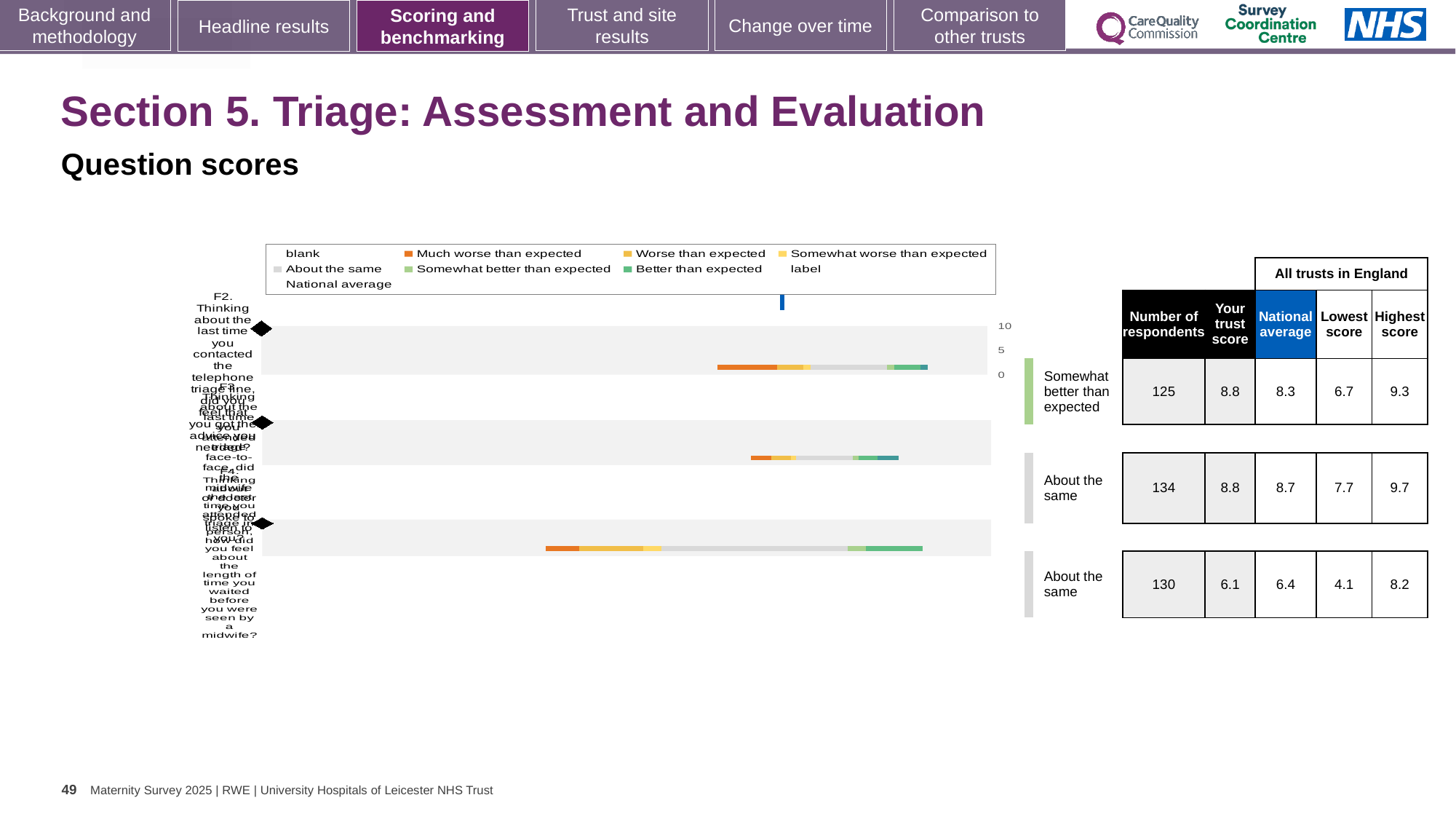
Which question has the lowest 'Your trust score'? F4 (6.1) For the second question (F3), what is the difference between the highest score and the lowest score? 2.0 For the third question (F4), how much higher is the national average than the trust score? 0.3 In the table beside the chart, what is the national average for the third question (F4)? 6.4 In the table beside the chart, what is 'Your trust score' for the first question (F2)? 8.8 Which question has the highest number of respondents? F3 (134) How many questions (rows) are plotted in the chart? 3 What kind of chart is shown on the slide? bar chart What benchmark category is shown for the first question (F2)? Somewhat better than expected In the chart legend, what colour represents 'Much worse than expected'? orange For the first question (F2), which is larger: the trust score or the national average? the trust score In the chart legend, what colour represents 'Better than expected'? green